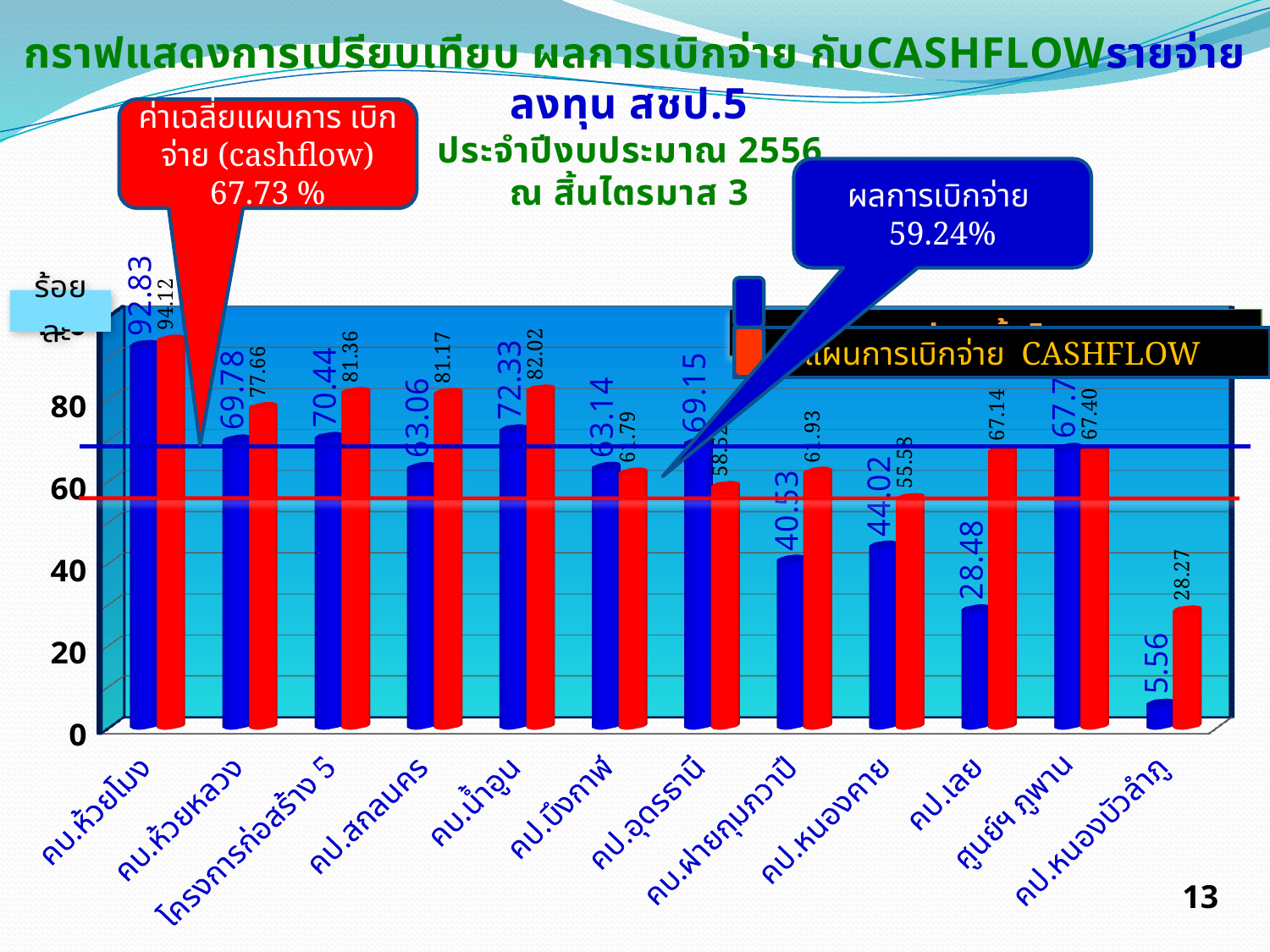
How many data series does the chart plot? 2 What average value is shown in the red callout for ค่าเฉลี่ยแผนการเบิกจ่าย (cashflow)? 67.73 % What is the value of the red (แผนการเบิกจ่าย CASHFLOW) bar for คบ.น้ำอูน? 82.02 What type of chart is shown on the slide? bar chart For คป.สกลนคร, which is larger: the blue bar or the red bar? the red bar What is the value of the blue bar for คบ.ห้วยโมง? 92.83 Which category has the lowest red (CASHFLOW) bar? คป.หนองบัวลำภู Is the blue bar for คป.เลย greater or less than 40? less What is the difference between the red bar (67.14) and the blue bar (28.48) for คป.เลย? 38.66 What is the value of the blue bar for คป.หนองบัวลำภู? 5.56 How many categories (offices/projects) are shown on the x axis? 12 Which category has the highest blue bar? คบ.ห้วยโมง